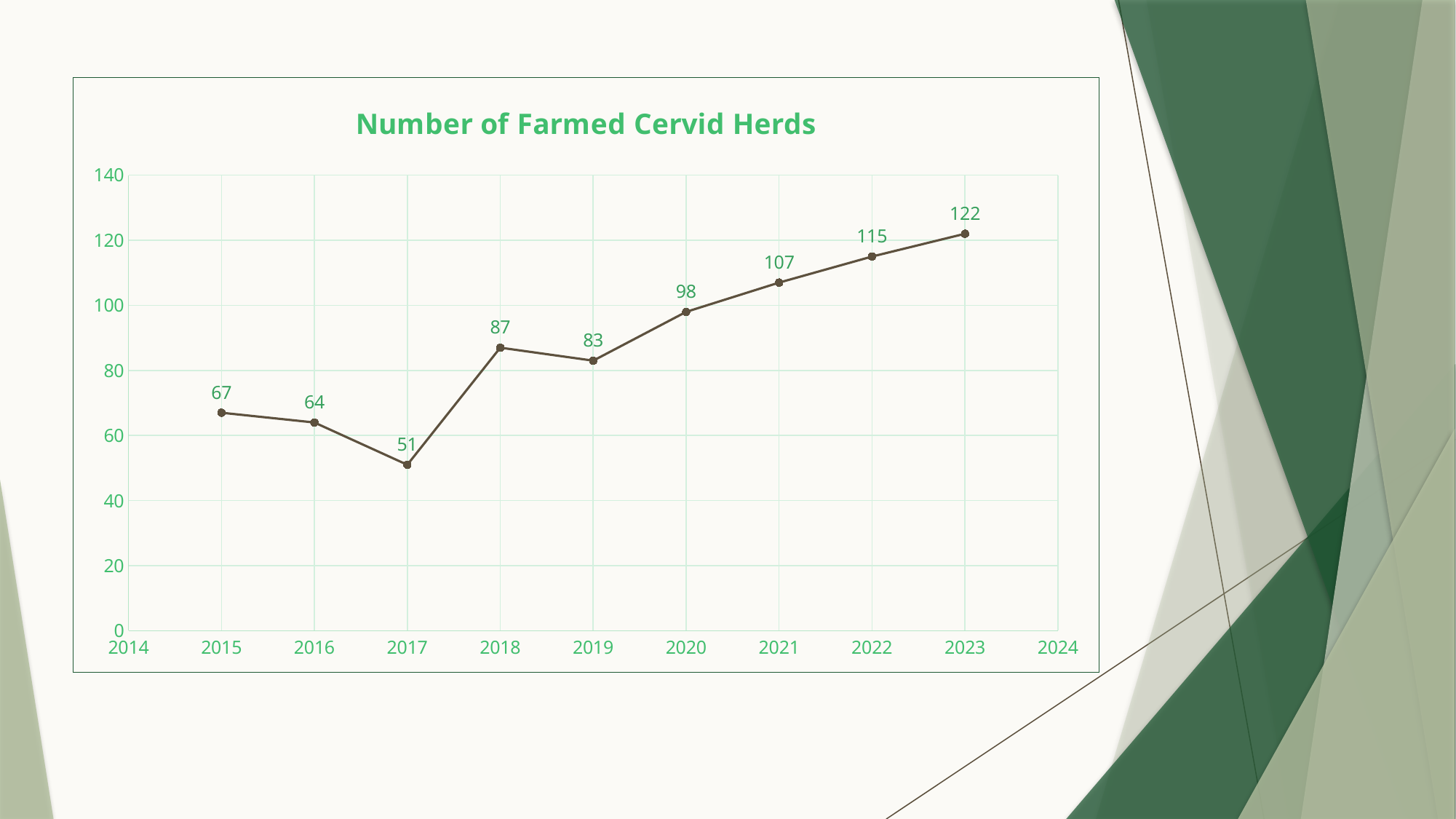
Which year has more farmed cervid herds, 2016 or 2020? 2020 How many data points are plotted on the chart? 9 What is the number of farmed cervid herds in 2017? 51 Is the value for 2022 greater or less than 100? greater What is the difference between the number of herds in 2023 and in 2015? 55 What is the difference between the number of herds in 2018 and in 2019? 4 What kind of chart is shown on the slide? Line chart Which year has the highest number of farmed cervid herds? 2023 What is the number of farmed cervid herds in 2021? 107 Which year has the lowest number of farmed cervid herds? 2017 What is the number of farmed cervid herds in 2015? 67 What is the title of the chart? Number of Farmed Cervid Herds